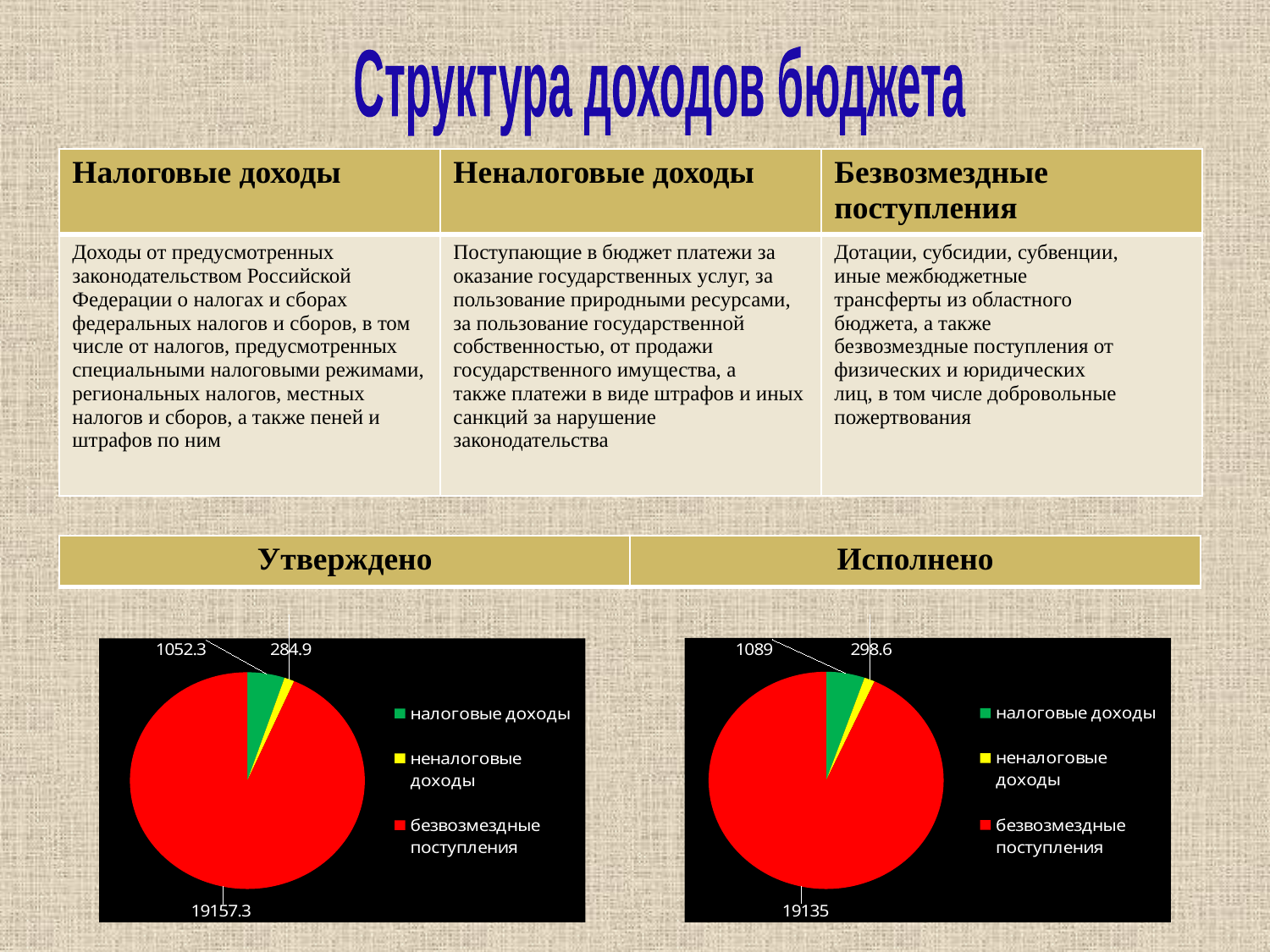
In the 'Исполнено' pie chart, what is the value for безвозмездные поступления? 19135 Which is larger: налоговые доходы in the 'Утверждено' chart or налоговые доходы in the 'Исполнено' chart? Исполнено In the 'Исполнено' pie chart, what is the difference between налоговые доходы and неналоговые доходы? 790.4 In the 'Утверждено' pie chart, which category has the largest slice? безвозмездные поступления In the 'Исполнено' pie chart, which category has the smallest slice? неналоговые доходы How many categories does the 'Исполнено' pie chart show? 3 In the 'Утверждено' pie chart, what is the value for налоговые доходы? 1052.3 What type of chart is used under 'Утверждено'? pie chart In the 'Исполнено' pie chart, what is the value for неналоговые доходы? 298.6 In the 'Утверждено' pie chart, what is the value for безвозмездные поступления? 19157.3 In the 'Утверждено' pie chart, what is the difference between налоговые доходы and неналоговые доходы? 767.4 In the 'Утверждено' pie chart, what colour is the slice for неналоговые доходы? yellow